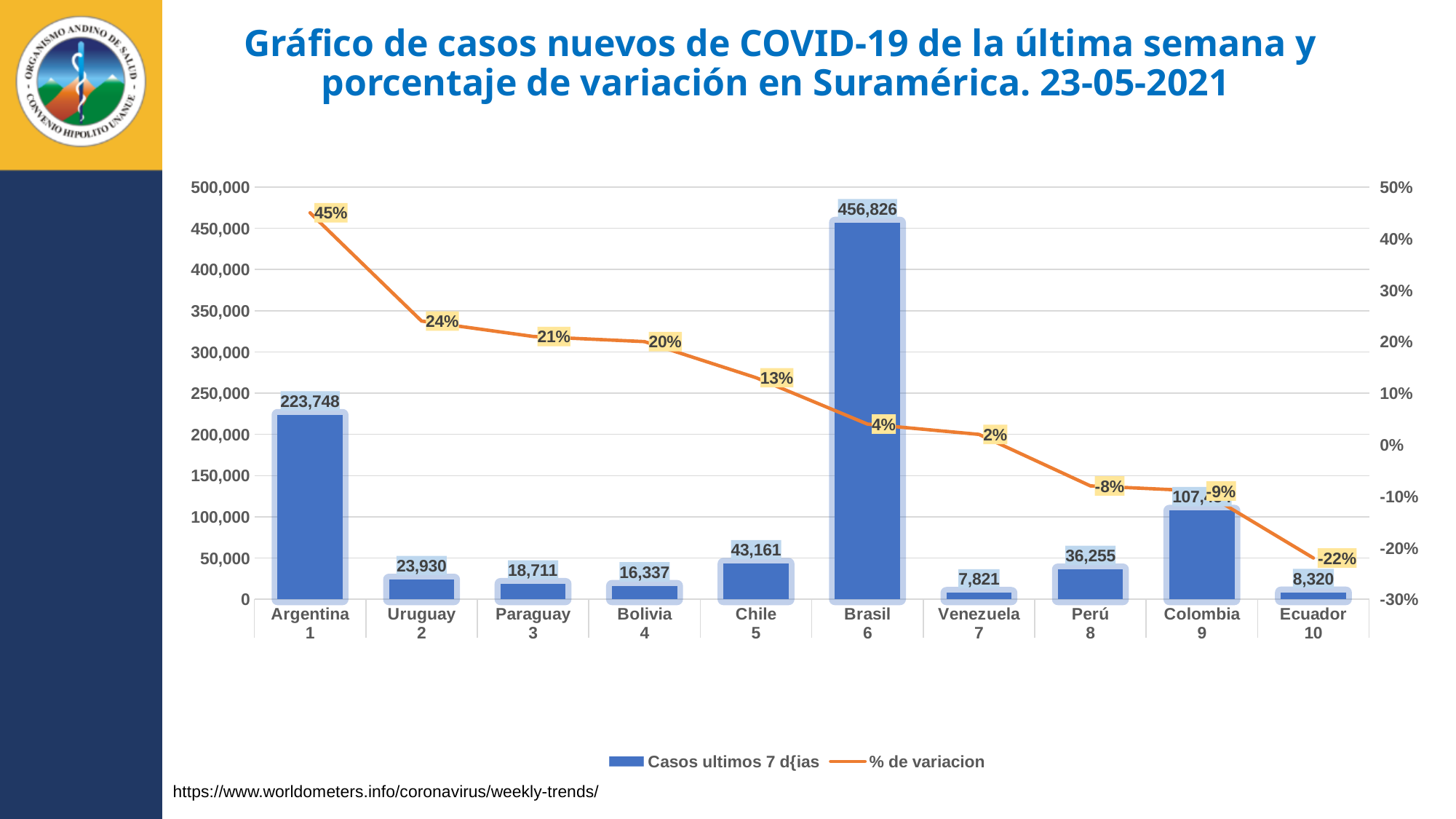
How many new cases in the last 7 days are shown for Brasil? 456,826 What is the difference in cases between Argentina and Chile? 180,587 Which has more cases in the last 7 days, Uruguay or Paraguay? Uruguay What is the percentage of variation shown for Argentina? 45% Is the number of cases for Colombia greater or less than 100,000? greater Which country has the highest number of cases in the last 7 days? Brasil Which country has the lowest percentage of variation? Ecuador Which country has the lowest number of cases in the last 7 days? Venezuela What is the percentage of variation shown for Perú? -8% What is the difference in cases between Uruguay and Paraguay? 5,219 How many series does the legend list? 2 How many countries are shown on the x axis? 10